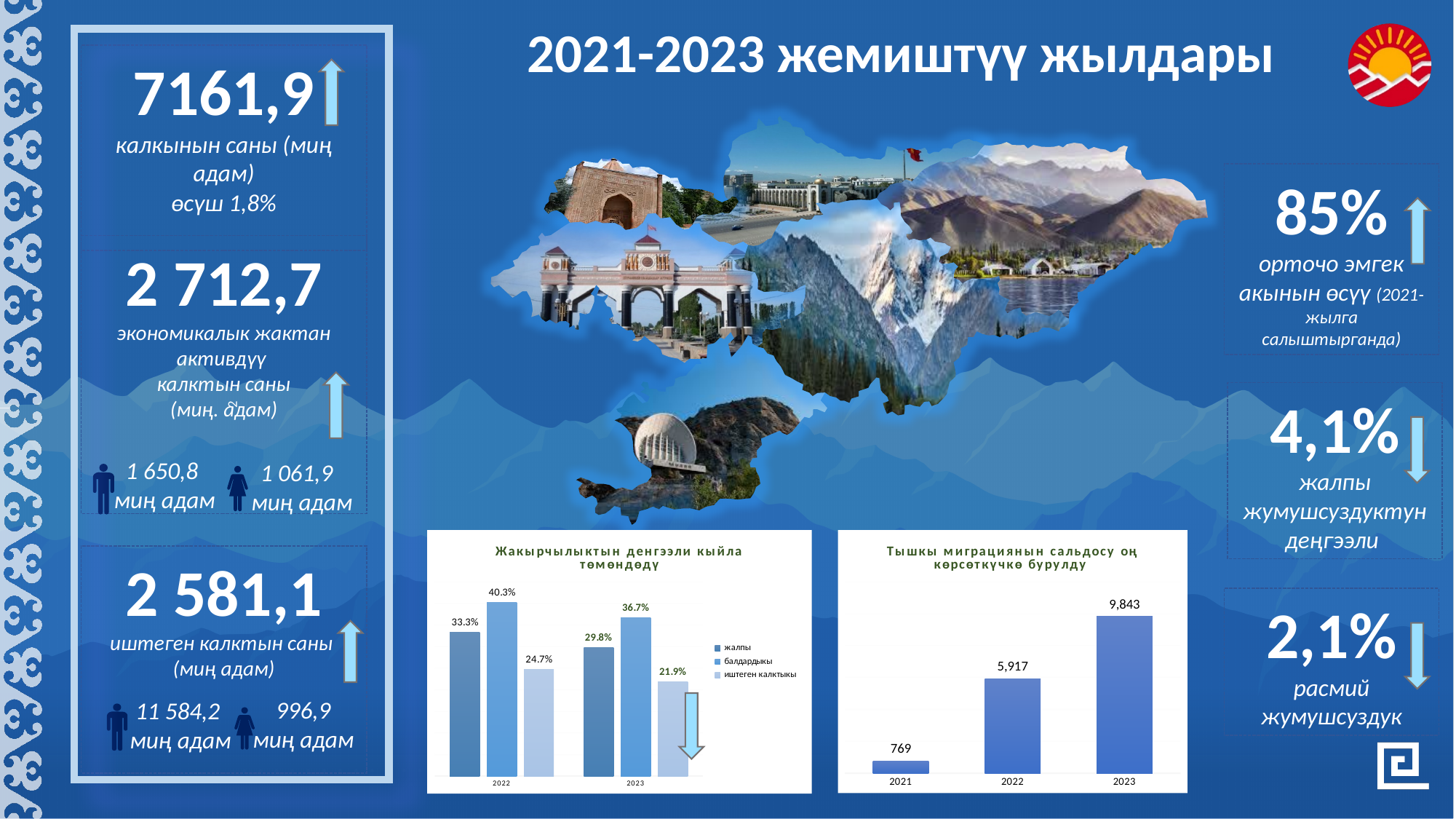
In the right chart (Тышкы миграциянын сальдосу оң көрсөткүчкө бурулду), what is the difference between the 2023 and 2022 values? 3,926 In the left chart (Жакырчылыктын деңгээли кыйла төмөндөдү), how many series does the legend list? 3 In the left chart (Жакырчылыктын деңгээли кыйла төмөндөдү), do the values rise or fall from 2022 to 2023? fall In the left chart (Жакырчылыктын деңгээли кыйла төмөндөдү), what is the value for жалпы in 2023? 29.8% In the left chart (Жакырчылыктын деңгээли кыйла төмөндөдү), what is the value for иштеген калктыкы in 2023? 21.9% In the right chart (Тышкы миграциянын сальдосу оң көрсөткүчкө бурулду), how many years are shown on the x axis? 3 In the left chart (Жакырчылыктын деңгээли кыйла төмөндөдү), which series has the highest value in 2023? балдардыкы In the left chart (Жакырчылыктын деңгээли кыйла төмөндөдү), what is the value for балдардыкы in 2022? 40.3% In the right chart (Тышкы миграциянын сальдосу оң көрсөткүчкө бурулду), what is the value for 2022? 5,917 In the right chart (Тышкы миграциянын сальдосу оң көрсөткүчкө бурулду), which year has the lowest value? 2021 In the left chart (Жакырчылыктын деңгээли кыйла төмөндөдү), by how many percentage points did the жалпы value fall from 2022 to 2023? 3.5 What kind of chart is the right chart (Тышкы миграциянын сальдосу оң көрсөткүчкө бурулду)? bar chart